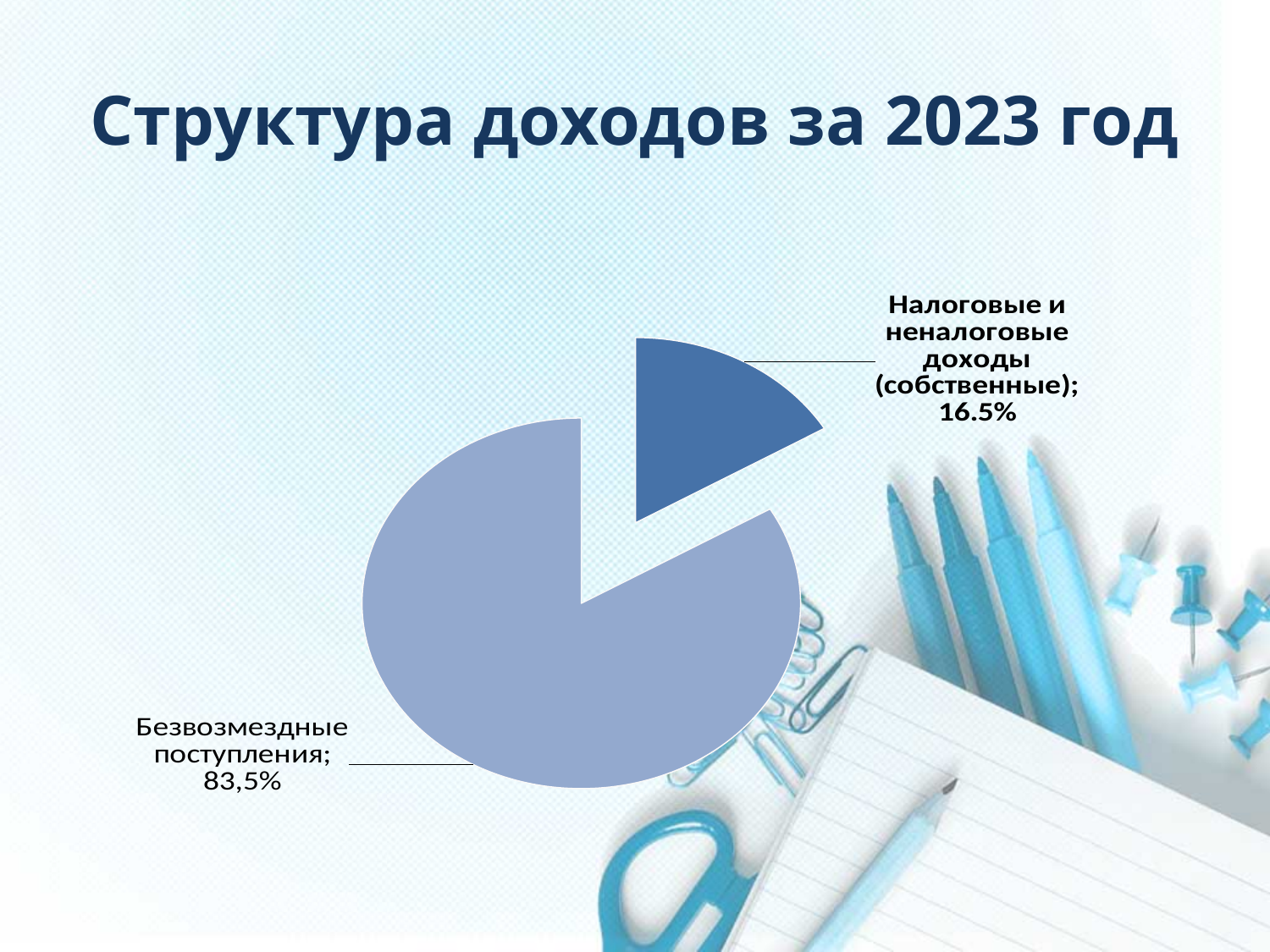
What is the title of the chart on the slide? Структура доходов за 2023 год Which slice of the pie is the largest? Безвозмездные поступления By how many percentage points does Безвозмездные поступления exceed Налоговые и неналоговые доходы (собственные)? 67 How many slices does the pie chart have? 2 Which is larger: Безвозмездные поступления or Налоговые и неналоговые доходы (собственные)? Безвозмездные поступления What type of chart is shown on the slide? pie chart Which slice of the pie is the smallest? Налоговые и неналоговые доходы (собственные) Which slice of the pie is drawn in the darker blue colour? Налоговые и неналоговые доходы (собственные) What share of the pie is labelled for Налоговые и неналоговые доходы (собственные)? 16.5% Is the share for Налоговые и неналоговые доходы (собственные) greater or less than 20%? less What share of the pie is labelled for Безвозмездные поступления? 83,5% Is the share for Безвозмездные поступления greater or less than 50%? greater